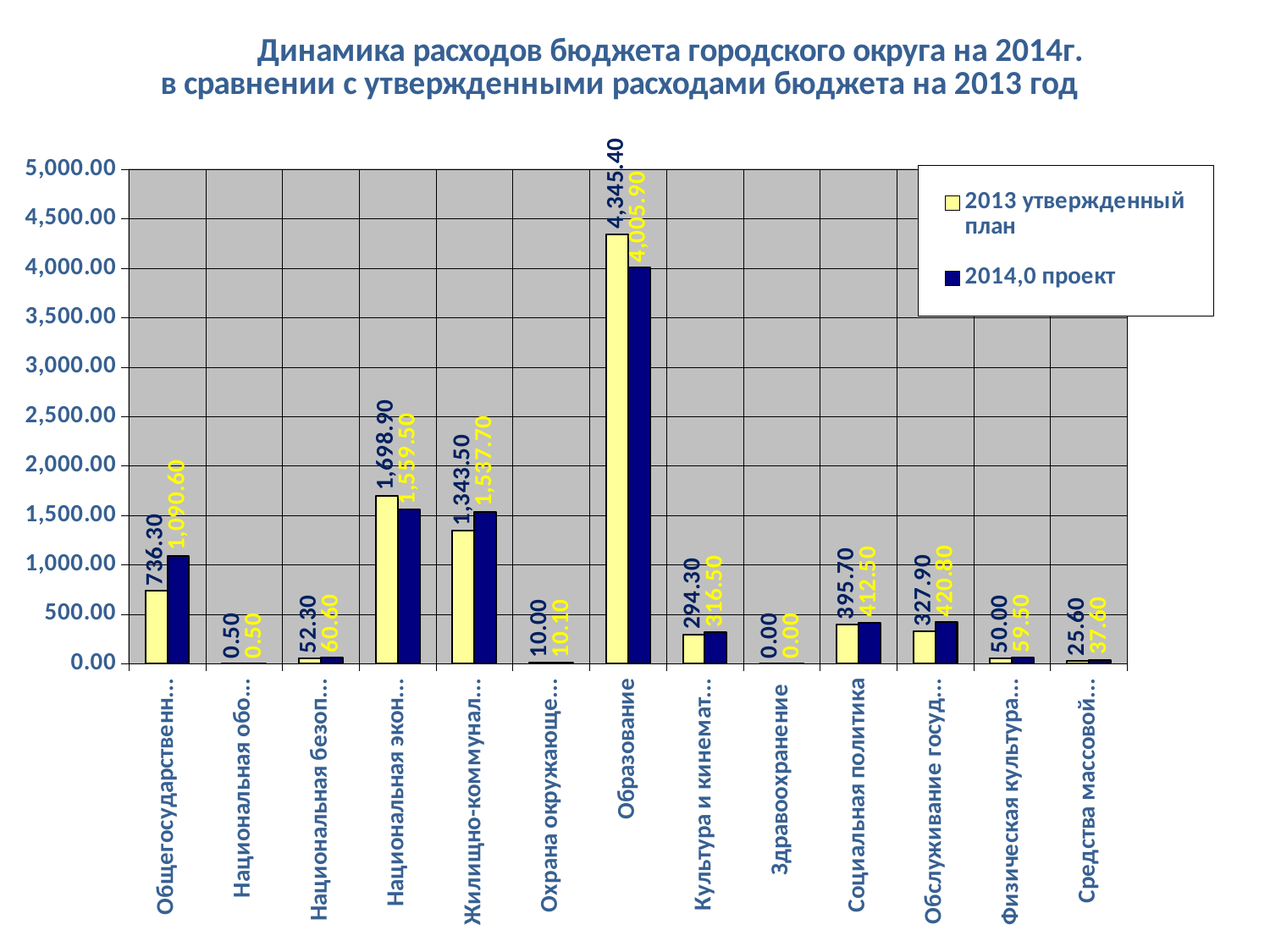
Which category has the highest value in the 2013 утвержденный план series? Образование What is the value of the 2014,0 проект series for Образование? 4,005.90 What is the difference between the 2014,0 проект and 2013 утвержденный план values for Социальная политика? 16.80 What type of chart is shown on the slide? bar chart What is the difference between the 2013 утвержденный план and 2014,0 проект values for Образование? 339.50 Is the 2013 утвержденный план value for Социальная политика greater or less than 500.00? less What is the value of the 2014,0 проект series for Социальная политика? 412.50 How many series does the legend list? 2 How many categories are shown on the x axis? 13 What is the value of the 2013 утвержденный план series for Здравоохранение? 0.00 What is the value of the 2013 утвержденный план series for Образование? 4,345.40 For Образование, which series has the larger value: 2013 утвержденный план or 2014,0 проект? 2013 утвержденный план